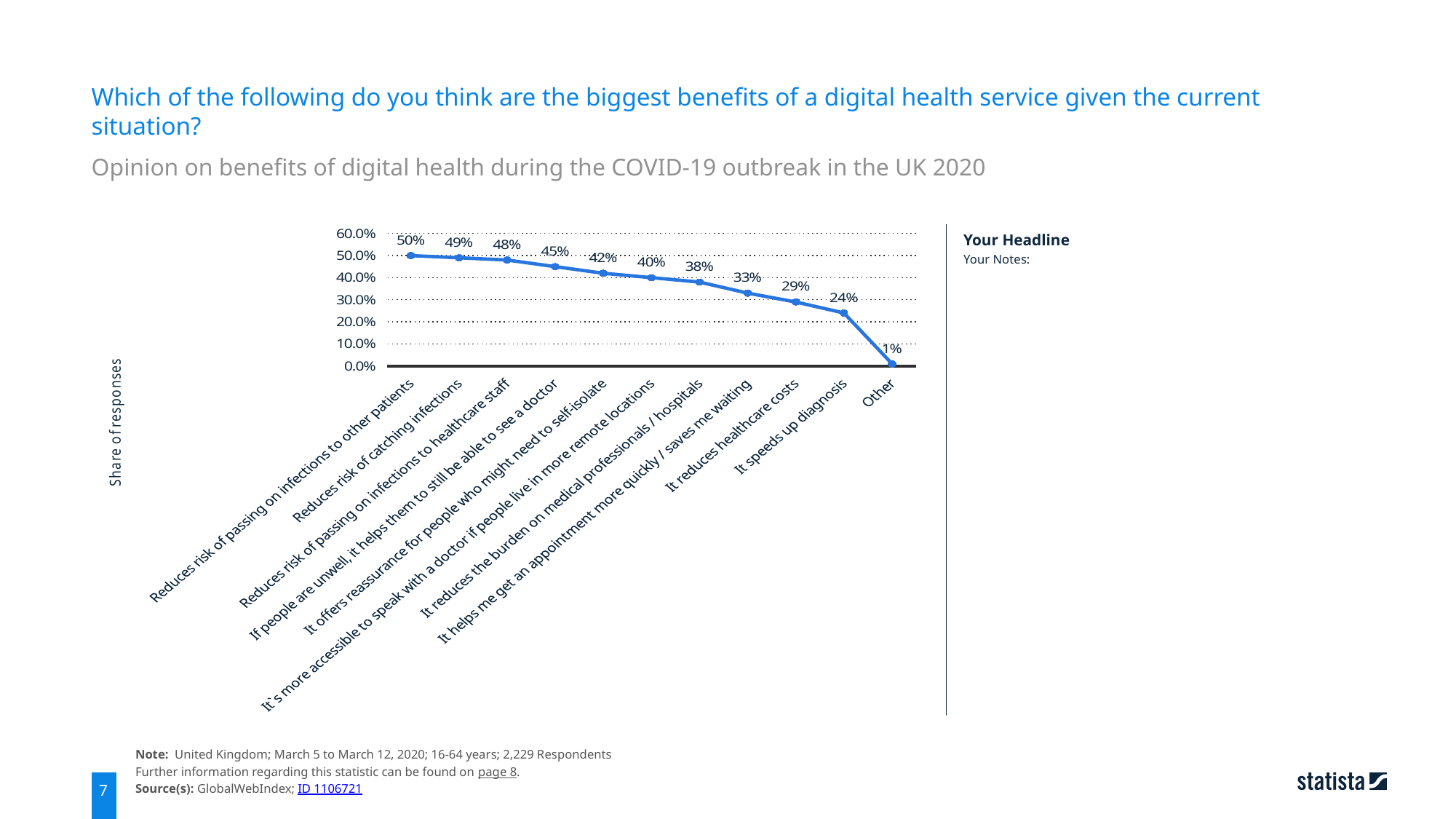
What is the label of the vertical axis? Share of responses Which category has the highest value? Reduces risk of passing on infections to other patients How many categories are plotted on the chart? 11 Do the values rise or fall from left to right along the x axis? Fall Which is larger: the value for "It helps me get an appointment more quickly / saves me waiting" or the value for "It reduces healthcare costs"? It helps me get an appointment more quickly / saves me waiting What is the difference between the values for "Reduces risk of passing on infections to other patients" and "It speeds up diagnosis"? 26% What is the value for "It reduces healthcare costs"? 29% Which category has the lowest value? Other What is the value for "Reduces risk of catching infections"? 49% What is the value for "It reduces the burden on medical professionals / hospitals"? 38% What kind of chart is shown on the slide? Line chart What is the value for "It speeds up diagnosis"? 24%